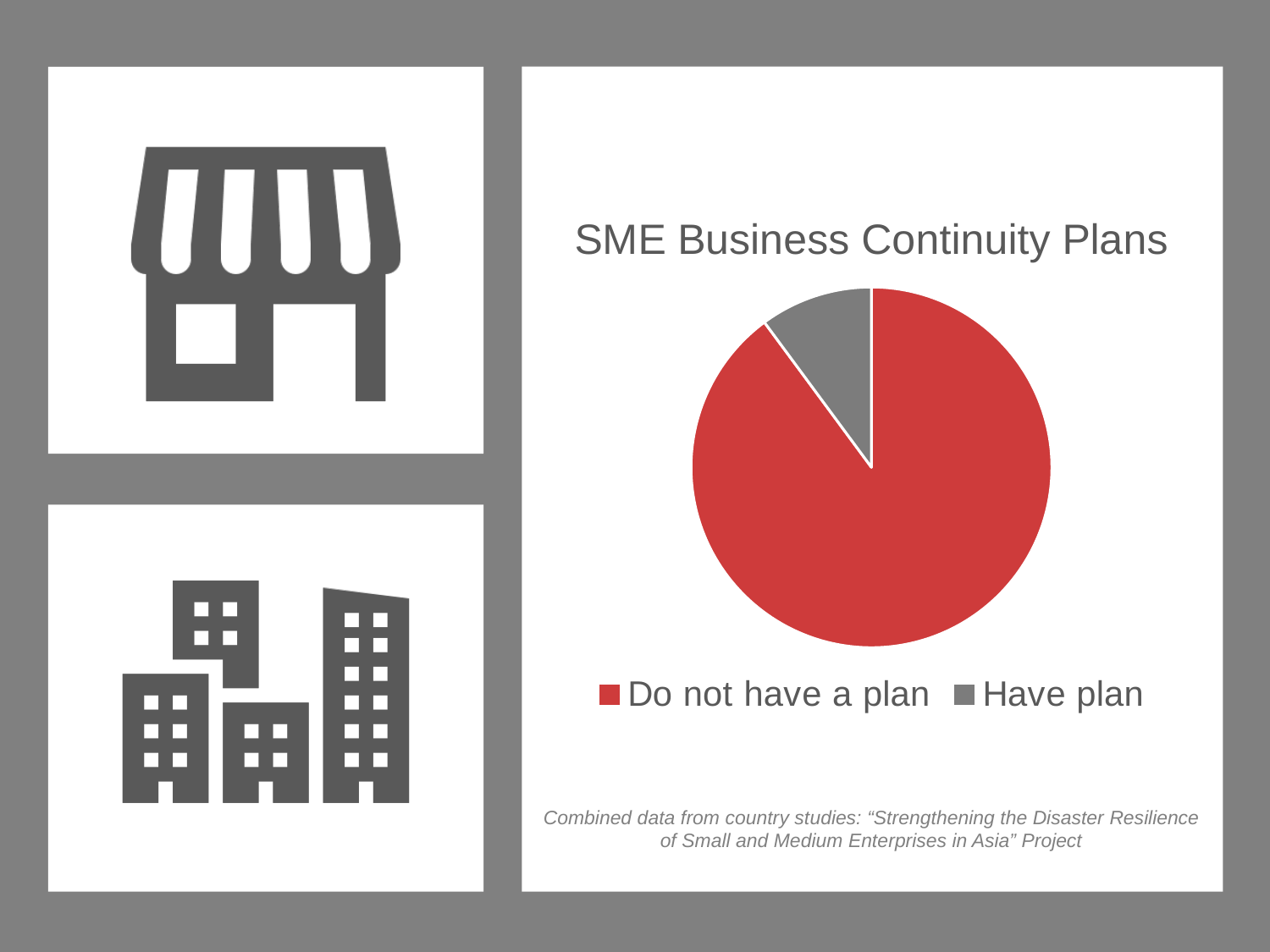
How many entries does the legend list? 2 What kind of chart is shown on the slide? pie chart What colour is the 'Have plan' slice? grey What is the title of the chart? SME Business Continuity Plans Which slice of the pie is the largest? Do not have a plan Is the share of SMEs that do not have a plan greater or less than half of the pie? greater Which slice of the pie is the smallest? Have plan How many slices does the pie chart have? 2 Which is larger, the 'Do not have a plan' slice or the 'Have plan' slice? Do not have a plan